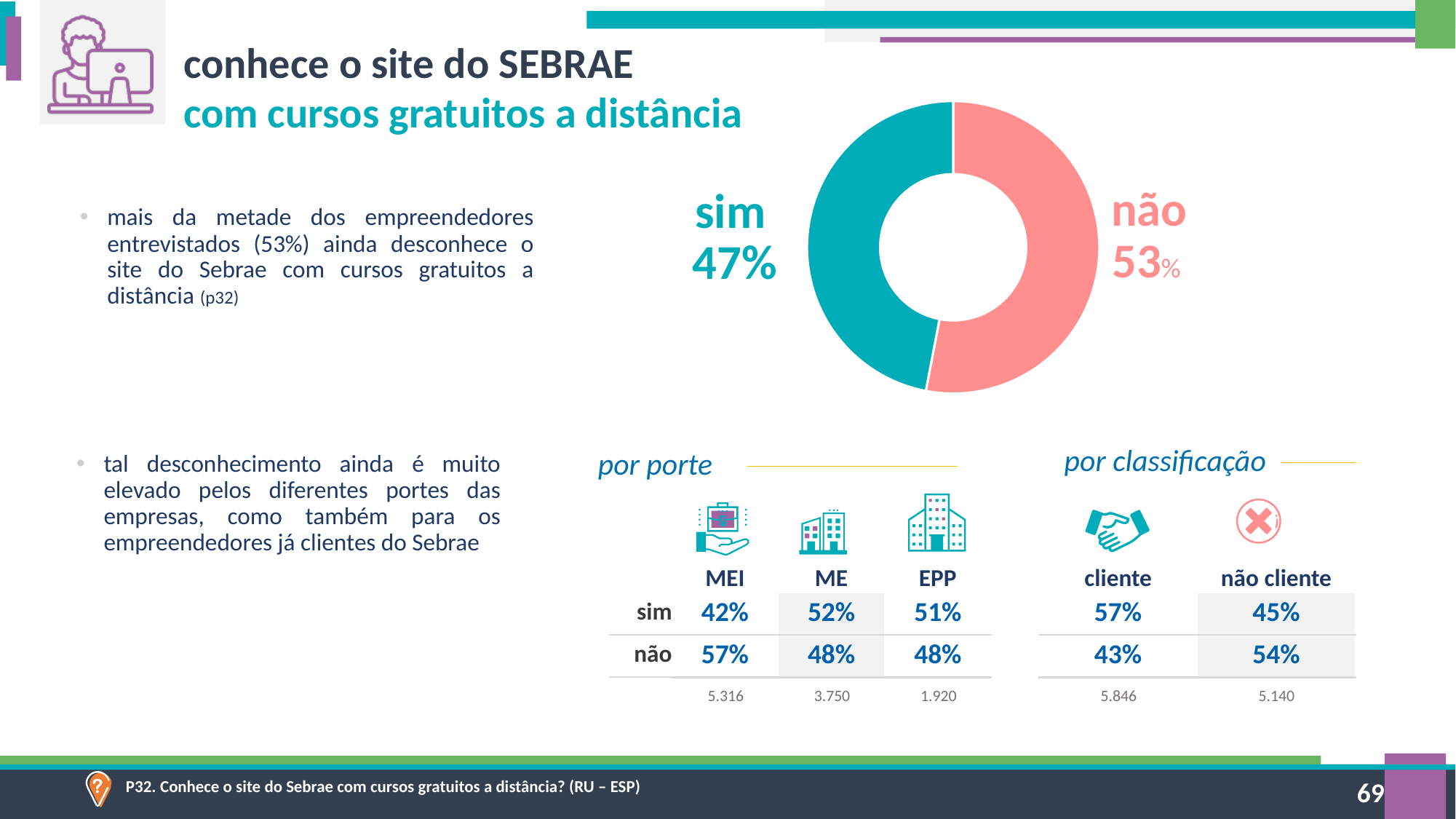
In the "por classificação" table, what percentage of "cliente" respondents answered "sim"? 57% What kind of chart is shown on the slide? pie chart (donut) How many slices does the donut chart have? 2 Which category has the smallest share in the donut chart? sim In the donut chart, what percentage of respondents answered "não"? 53% In the "por porte" table, what percentage of MEI respondents answered "não"? 57% What colour is the "sim" slice of the donut chart? teal What is the difference in percentage points between the "não" and "sim" slices of the donut chart? 6 In the "por porte" table, which porte has the highest "sim" percentage? ME Which slice of the donut chart is larger, "sim" or "não"? não In the donut chart, what percentage of respondents answered "sim"? 47% What colour is the "não" slice of the donut chart? pink